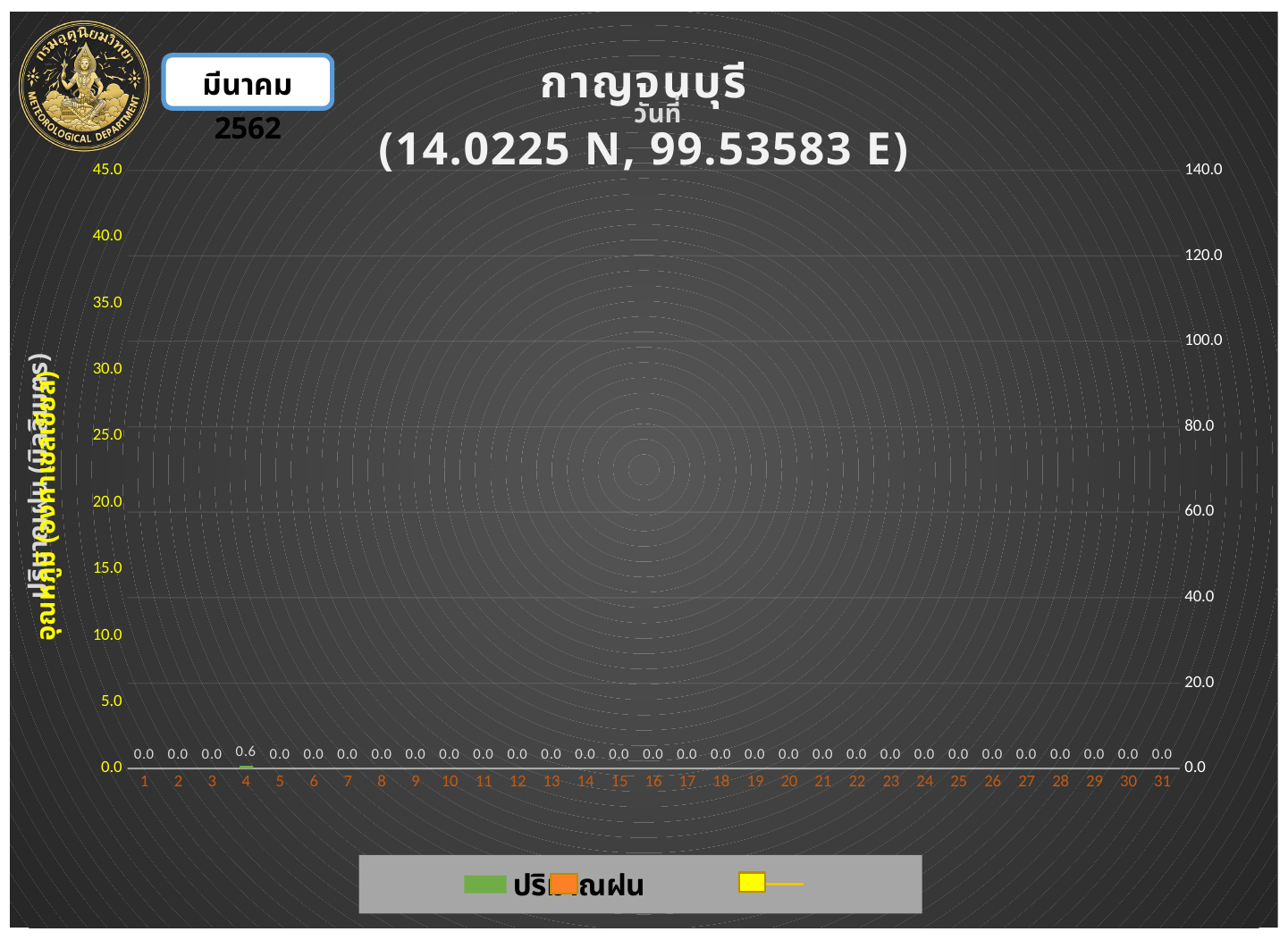
Is the rainfall value for day 4 greater or less than 5.0? less What is the highest tick value on the right vertical axis? 140.0 What kind of chart is this? bar chart Which has the larger rainfall value, day 4 or day 10? day 4 What is the rainfall value shown for day 4? 0.6 What is the rainfall value shown for day 1? 0.0 What is the highest tick value on the left vertical axis? 45.0 What is the difference between the rainfall values for day 4 and day 1? 0.6 Which day has the highest rainfall value? 4 What is the rainfall value shown for day 31? 0.0 How many days are shown on the x axis? 31